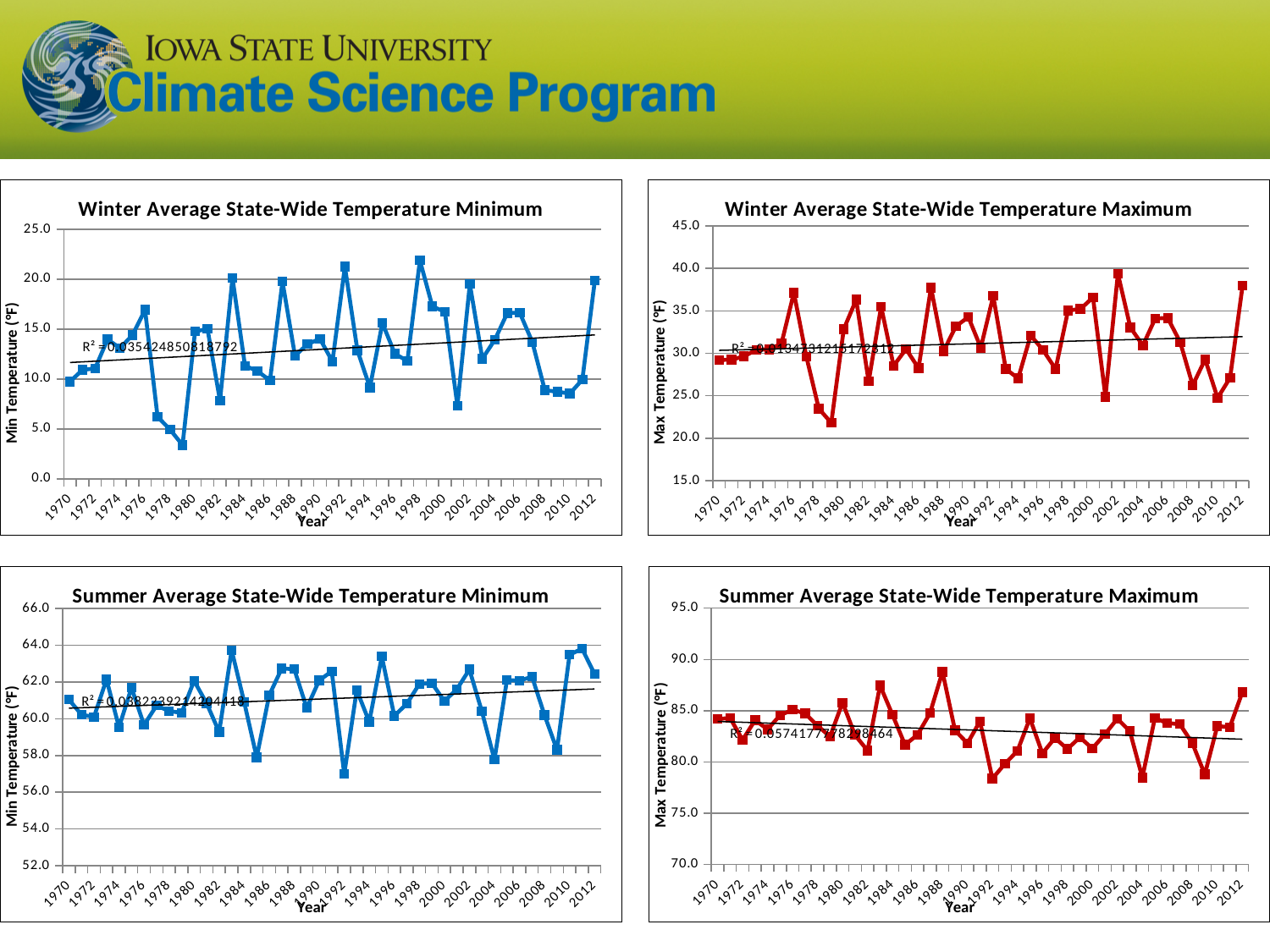
In the Winter Average State-Wide Temperature Minimum chart, which year has the lowest value? 1979 In the Summer Average State-Wide Temperature Maximum chart, is the value for 1988 larger or smaller than the value for 1991? larger In the Summer Average State-Wide Temperature Maximum chart, does the fitted trend line rise or fall from 1970 to 2012? fall In the Summer Average State-Wide Temperature Maximum chart, which year has the highest value? 1988 In the Winter Average State-Wide Temperature Minimum chart, is the value for 1998 greater or less than 20.0? greater In the Summer Average State-Wide Temperature Minimum chart, is the value for 1983 greater or less than 62.0? greater In the Winter Average State-Wide Temperature Minimum chart, is the value for 1979 greater or less than 5.0? less How many charts are shown on the slide? 4 In the Winter Average State-Wide Temperature Maximum chart, which year has the highest value? 2002 What kind of chart is the Winter Average State-Wide Temperature Minimum chart? line chart